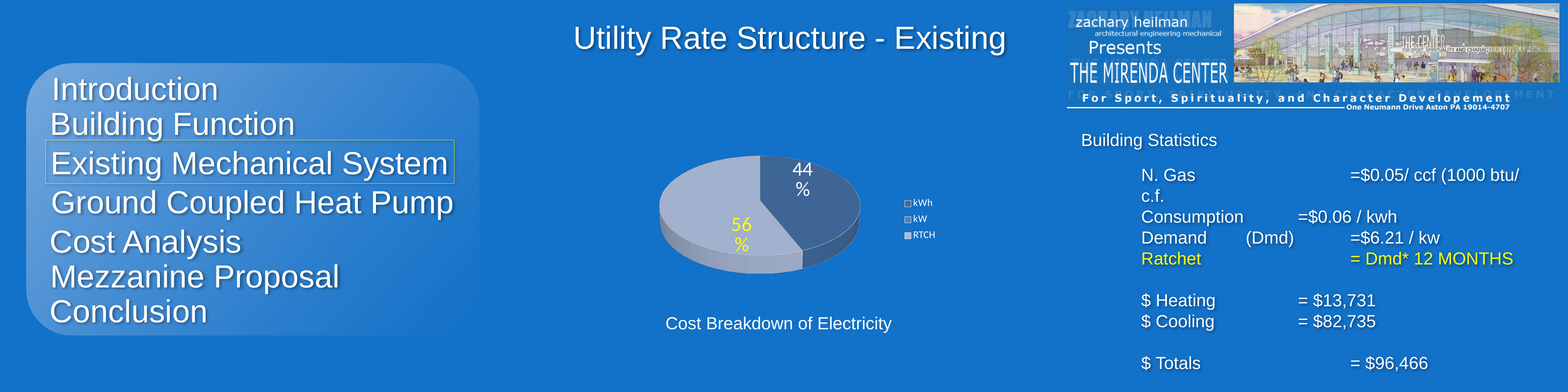
What percentage is labelled on the smaller, dark blue slice of the pie chart? 44% What kind of chart is shown on the slide? pie chart How many entries does the pie chart's legend list? 3 What is the difference in percentage points between the 56% slice and the 44% slice? 12 percentage points What share of the pie does the kWh slice represent? 44% What is the title shown beneath the pie chart? Cost Breakdown of Electricity Which slice of the pie chart is the largest? RTCH (56%) How many slices with visible percentage labels does the pie chart have? 2 What are the entries listed in the pie chart's legend? kWh, kW, RTCH What percentage is labelled on the larger, light blue slice of the pie chart? 56%